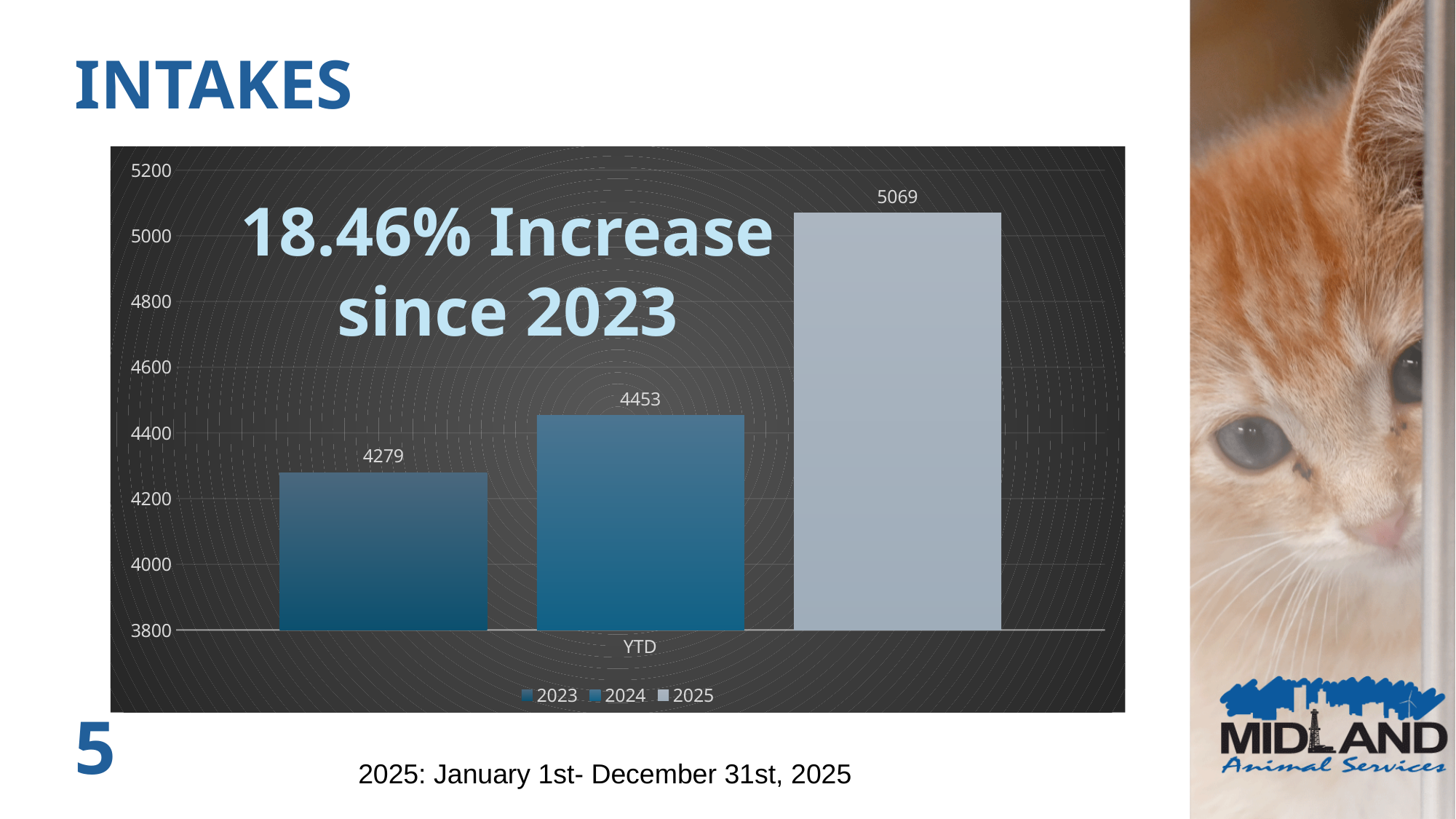
What kind of chart is shown on the slide? bar chart What is the difference between the 2024 and 2023 intake values? 174 How many series does the legend list? 3 What is the intake value for 2025? 5069 Which year has the lowest intake value? 2023 What is the intake value for 2024? 4453 Is the intake value for 2025 greater or less than 5000? greater What is the difference between the 2025 and 2023 intake values? 790 What is the intake value for 2023? 4279 Which year has the highest intake value? 2025 Which is larger, the intake value for 2024 or for 2025? 2025 What percentage increase since 2023 is stated on the chart? 18.46%